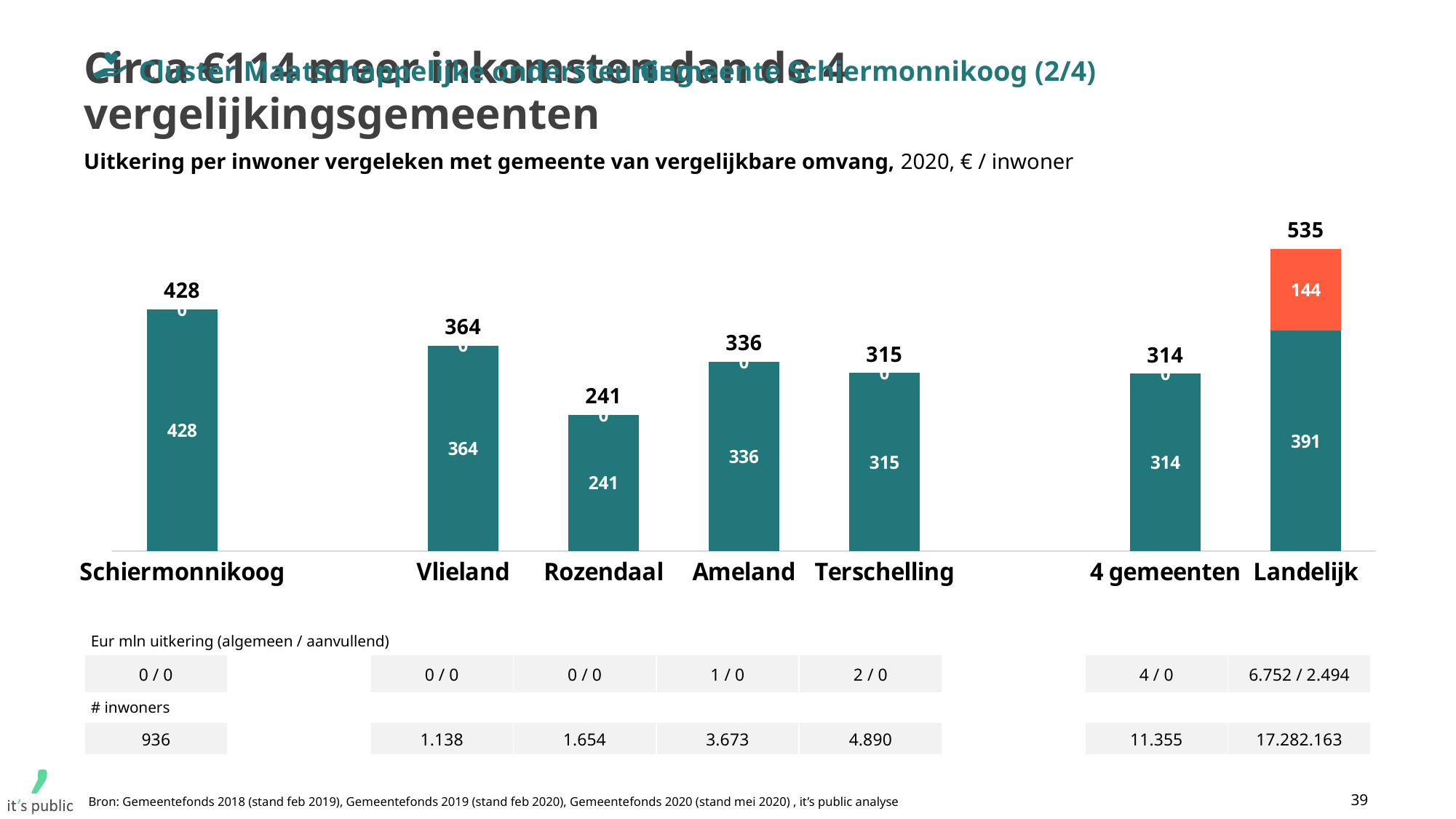
What is the value of the orange (top) segment of the Landelijk bar? 144 What is the difference between the values for Terschelling and Rozendaal? 74 Which category has the lowest value? Rozendaal How many categories are shown on the x axis? 7 What is the value for Rozendaal? 241 Which category has the highest total value? Landelijk What is the value for Schiermonnikoog? 428 What is the value for 4 gemeenten? 314 What kind of chart is shown on the slide? Bar chart Which is larger, the value for Vlieland or the value for Ameland? Vlieland What is the difference between the values for Schiermonnikoog and 4 gemeenten? 114 What is the total of the stacked bar for Landelijk? 535